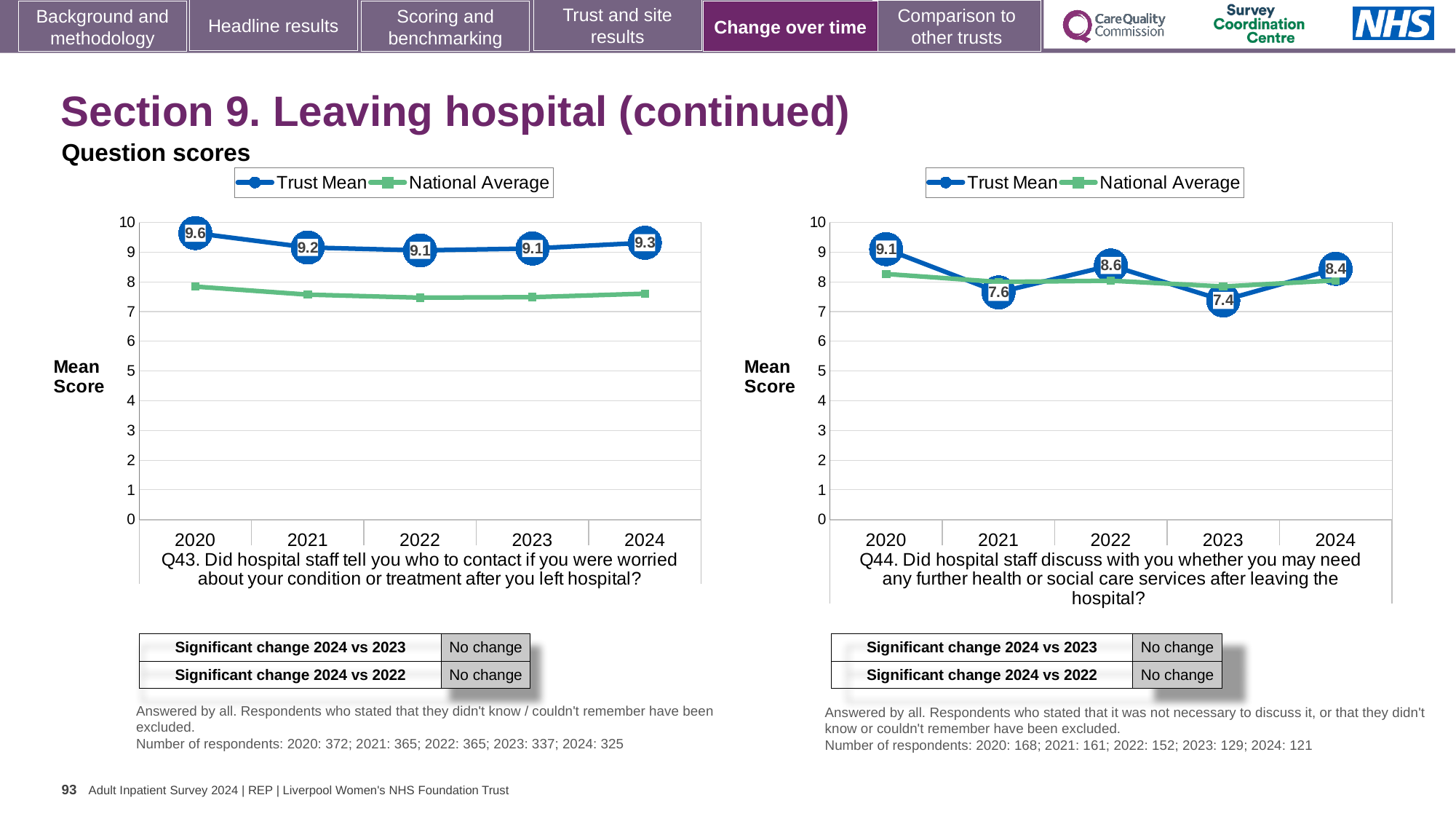
In the Q43 chart on the left, what is the Trust Mean score for 2024? 9.3 In the Q43 chart on the left, what is the Trust Mean score for 2020? 9.6 In the Q43 chart on the left, is the National Average value for 2022 greater or less than 8? less In the Q44 chart on the right, which year has the highest Trust Mean score? 2020 In the Q44 chart on the right, is the Trust Mean score for 2022 or 2024 higher? 2022 In the Q44 chart on the right, which year has the lowest Trust Mean score? 2023 What type of chart is the Q43 chart on the left? Line chart In the Q43 chart on the left, what is the difference between the Trust Mean scores for 2020 and 2022? 0.5 How many years are shown on the x axis of the Q43 chart on the left? 5 How many series does the legend of the Q44 chart on the right list? 2 In the Q44 chart on the right, what is the Trust Mean score for 2023? 7.4 In the Q44 chart on the right, what is the difference between the Trust Mean scores for 2022 and 2021? 1.0